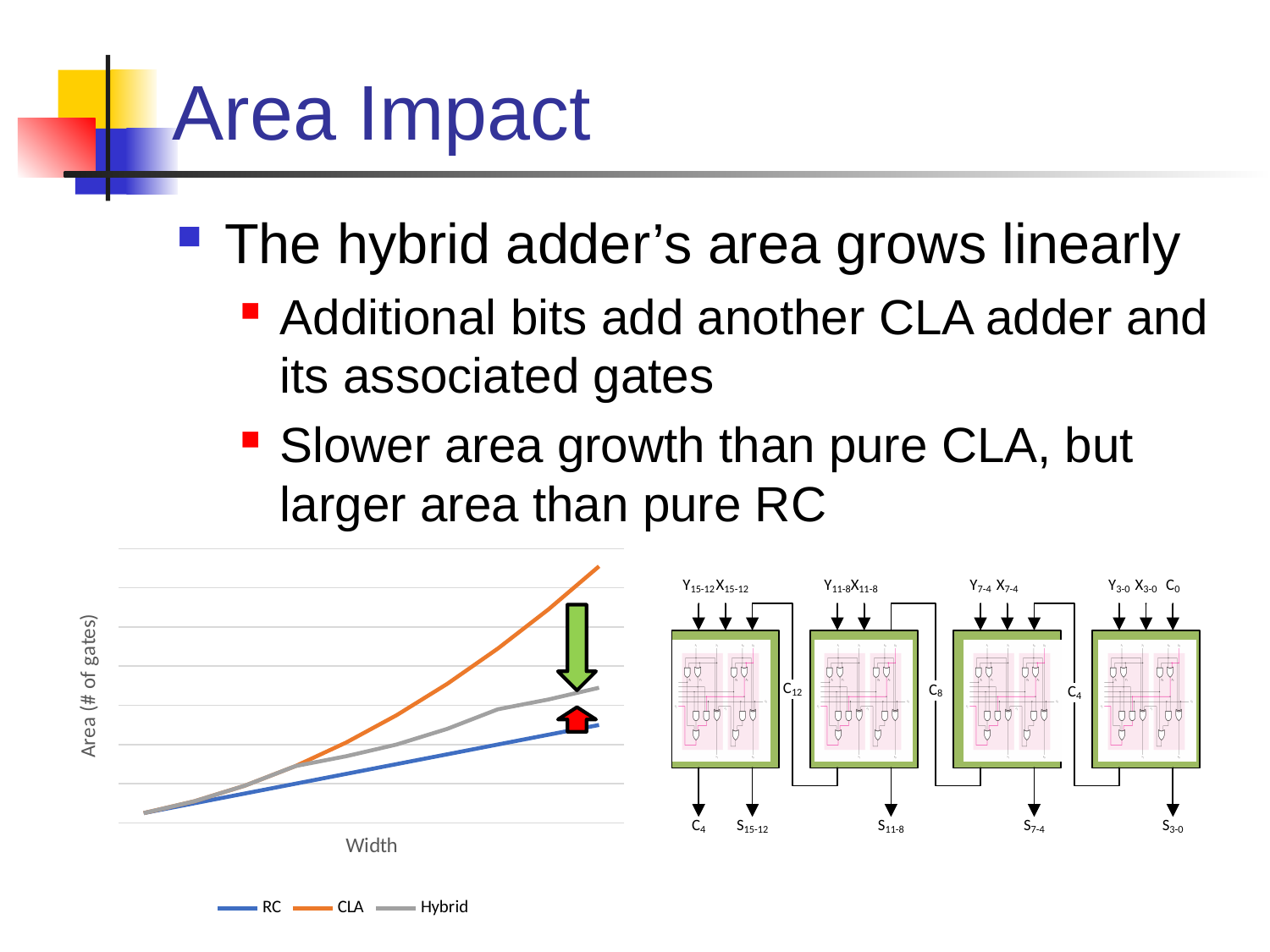
How many series does the chart's legend list? 3 At the largest width, which series has the larger area, Hybrid or RC? Hybrid Does the area for the CLA series rise or fall as width increases? rise What is the label of the chart's horizontal axis? Width Which series reaches the highest area at the largest width on the chart? CLA Does the area for the Hybrid series rise or fall as width increases? rise What is the label of the chart's vertical axis? Area (# of gates) At the largest width, which series has the larger area, CLA or Hybrid? CLA What kind of chart is shown on the slide? line chart Which series has the lowest area at the largest width on the chart? RC